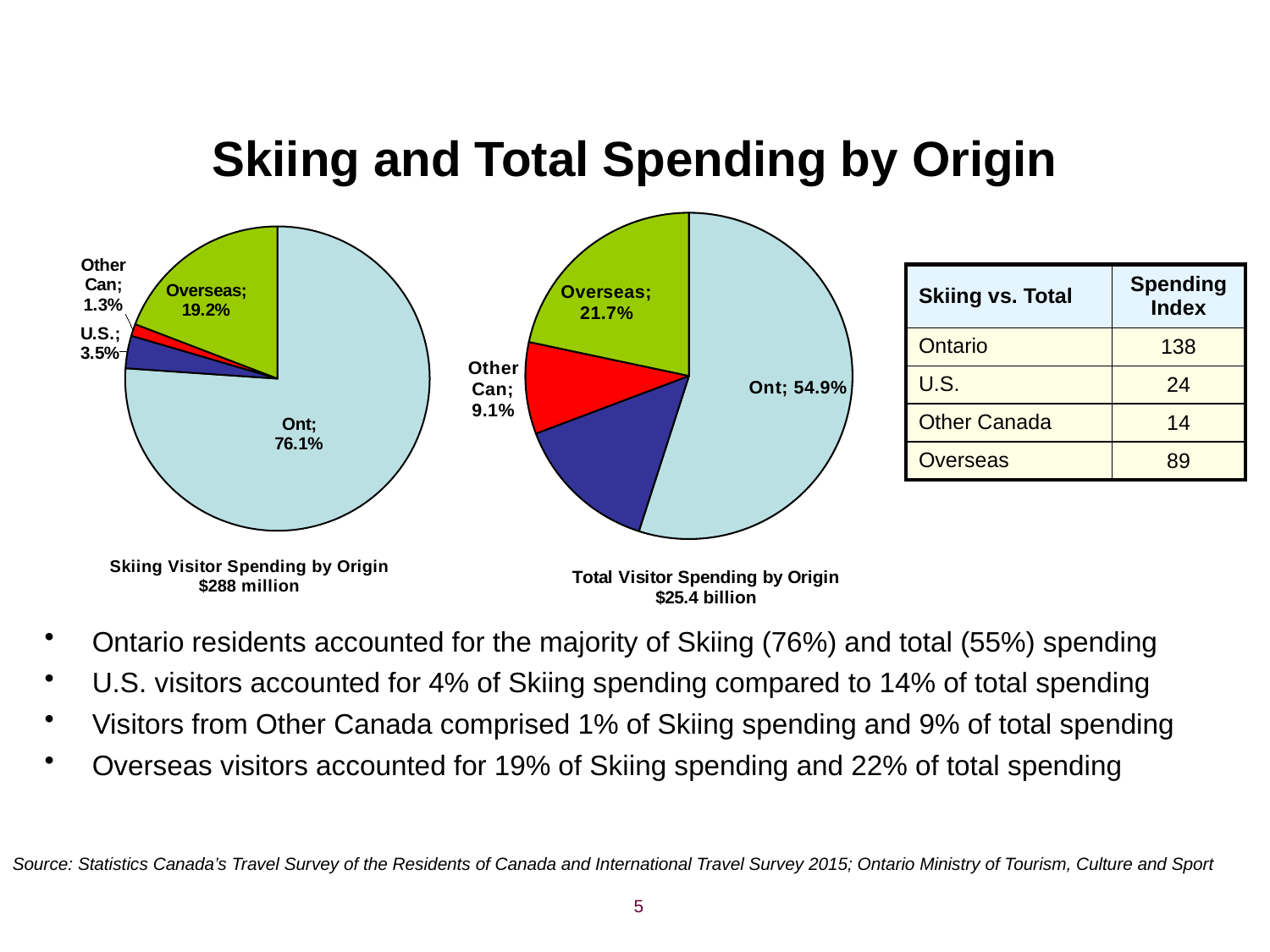
In the Skiing Visitor Spending by Origin chart, what share of spending comes from the U.S.? 3.5% In the Total Visitor Spending by Origin chart, which origin has the largest share? Ont In the Skiing Visitor Spending by Origin chart, which origin has the smallest share? Other Can In the Total Visitor Spending by Origin chart, what share of spending comes from Overseas visitors? 21.7% How many slices does the Total Visitor Spending by Origin pie chart have? 4 In the Skiing Visitor Spending by Origin chart, what share of spending comes from Other Canada? 1.3% In the Total Visitor Spending by Origin chart, what share of spending comes from Other Canada? 9.1% In the Skiing Visitor Spending by Origin chart, what is the difference between the Ontario share and the Overseas share? 56.9% What type of chart is used for Skiing Visitor Spending by Origin? Pie chart In the Skiing Visitor Spending by Origin chart, what share of spending comes from Overseas visitors? 19.2% In the Total Visitor Spending by Origin chart, what share of spending comes from Ontario? 54.9% In the Skiing Visitor Spending by Origin chart, what share of spending comes from Ontario? 76.1%